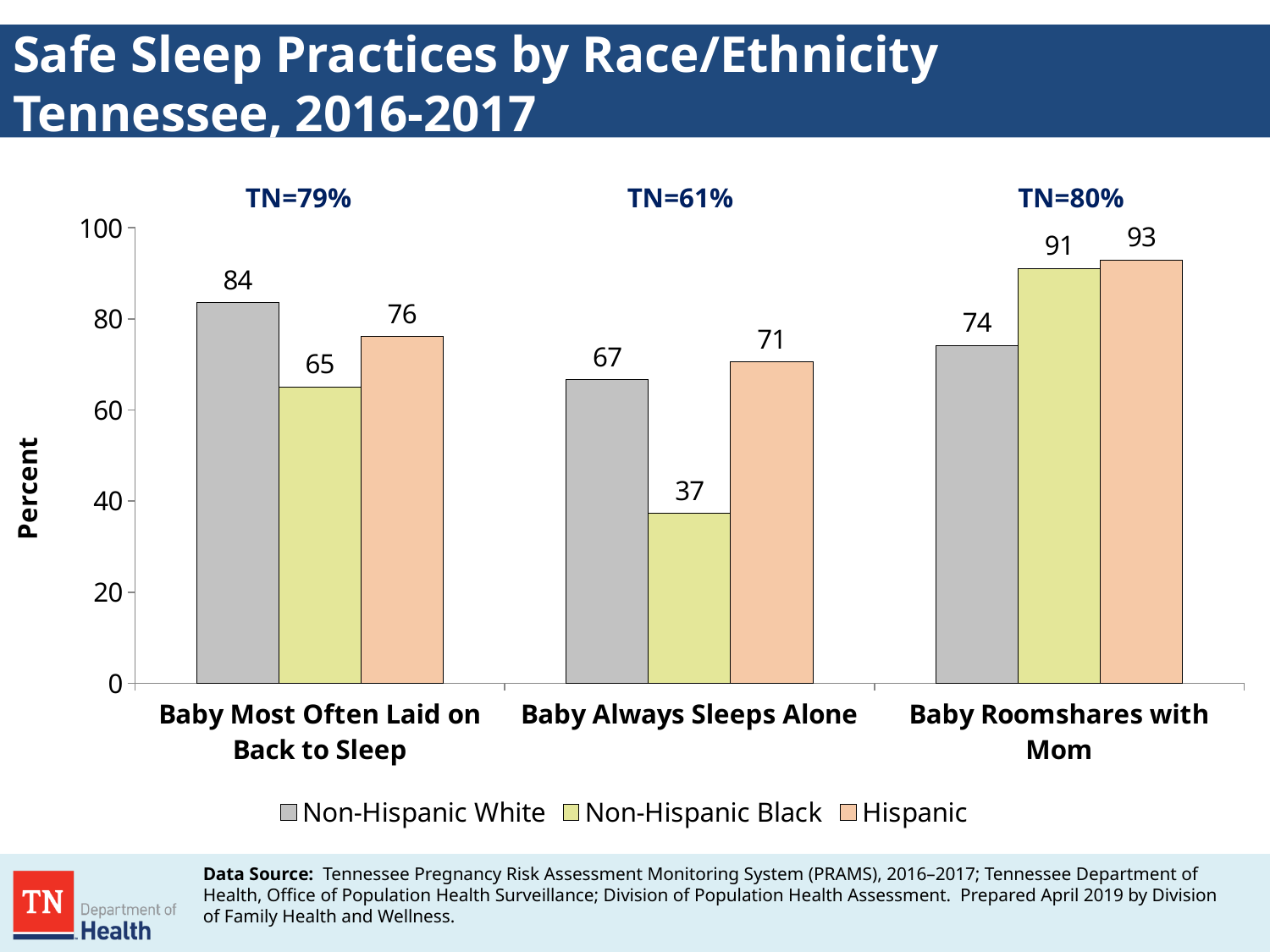
What is the label on the y axis? Percent What is the value for Hispanic for Baby Roomshares with Mom? 93 Which race/ethnicity group has the lowest value for Baby Always Sleeps Alone? Non-Hispanic Black What is the difference between the Non-Hispanic White and Non-Hispanic Black values for Baby Most Often Laid on Back to Sleep? 19 What is the value for Non-Hispanic White for Baby Most Often Laid on Back to Sleep? 84 Which race/ethnicity group has the highest value for Baby Roomshares with Mom? Hispanic What kind of chart is shown on the slide? Bar chart How many series does the legend list? 3 Which is larger for Baby Always Sleeps Alone: the Non-Hispanic White value or the Hispanic value? Hispanic How many safe sleep practice categories are shown on the x axis? 3 What is the value for Non-Hispanic Black for Baby Always Sleeps Alone? 37 What is the Tennessee overall value shown above the Baby Always Sleeps Alone category? TN=61%